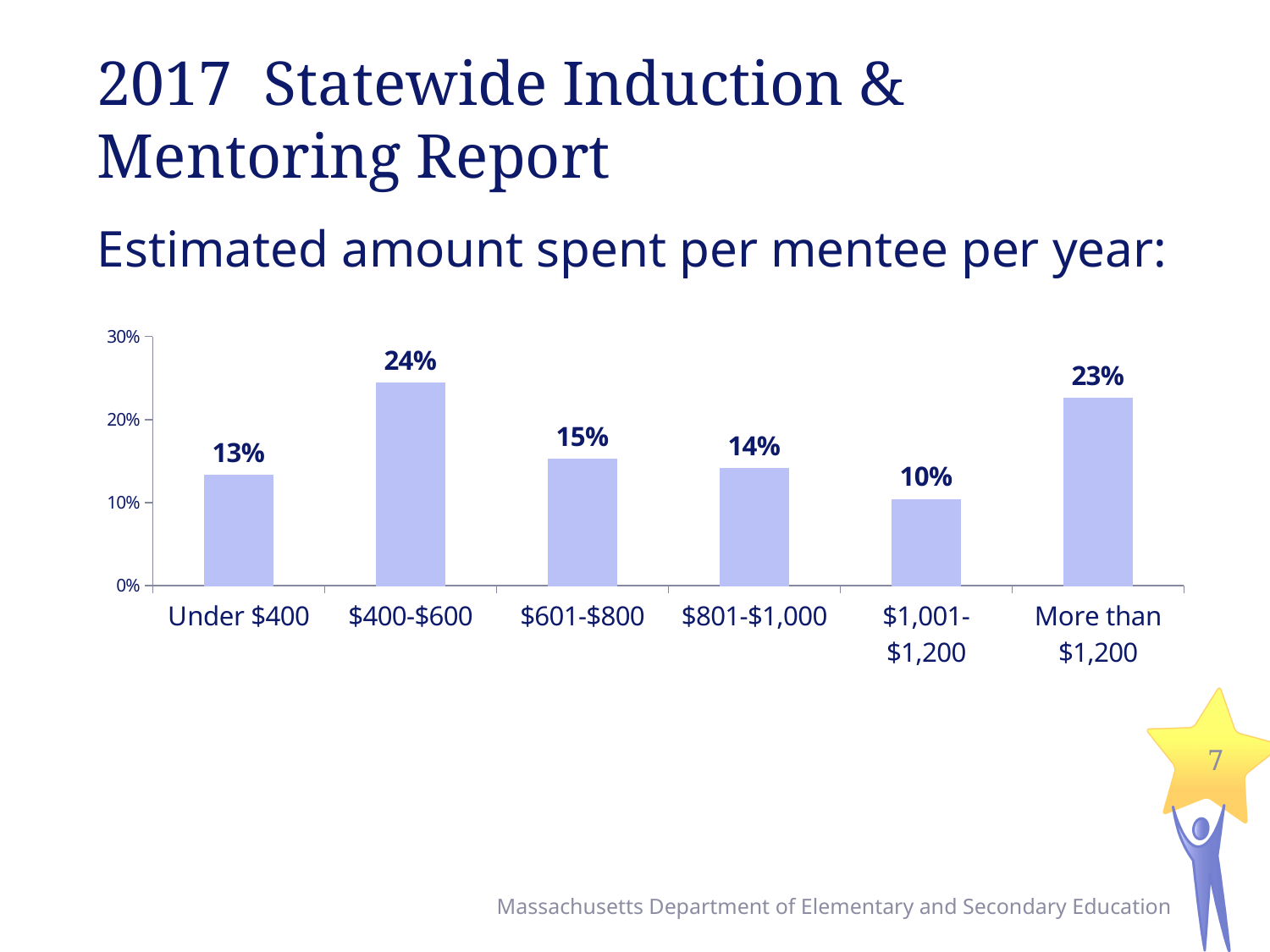
What is the difference between the percentages for '$601-$800' and '$1,001-$1,200'? 5% What percentage is shown for the '$1,001-$1,200' category? 10% What is the highest value shown on the y axis? 30% Which has a larger percentage: '$601-$800' or '$801-$1,000'? $601-$800 Which spending category has the lowest percentage? $1,001-$1,200 What is the difference between the percentages for '$400-$600' and 'More than $1,200'? 1% What kind of chart is shown on the slide? Bar chart Is the value for 'More than $1,200' greater or less than 20%? greater How many spending categories are shown on the x axis? 6 Which spending category has the highest percentage? $400-$600 What percentage of respondents estimated spending $400-$600 per mentee per year? 24% What is the value shown for the 'Under $400' category? 13%